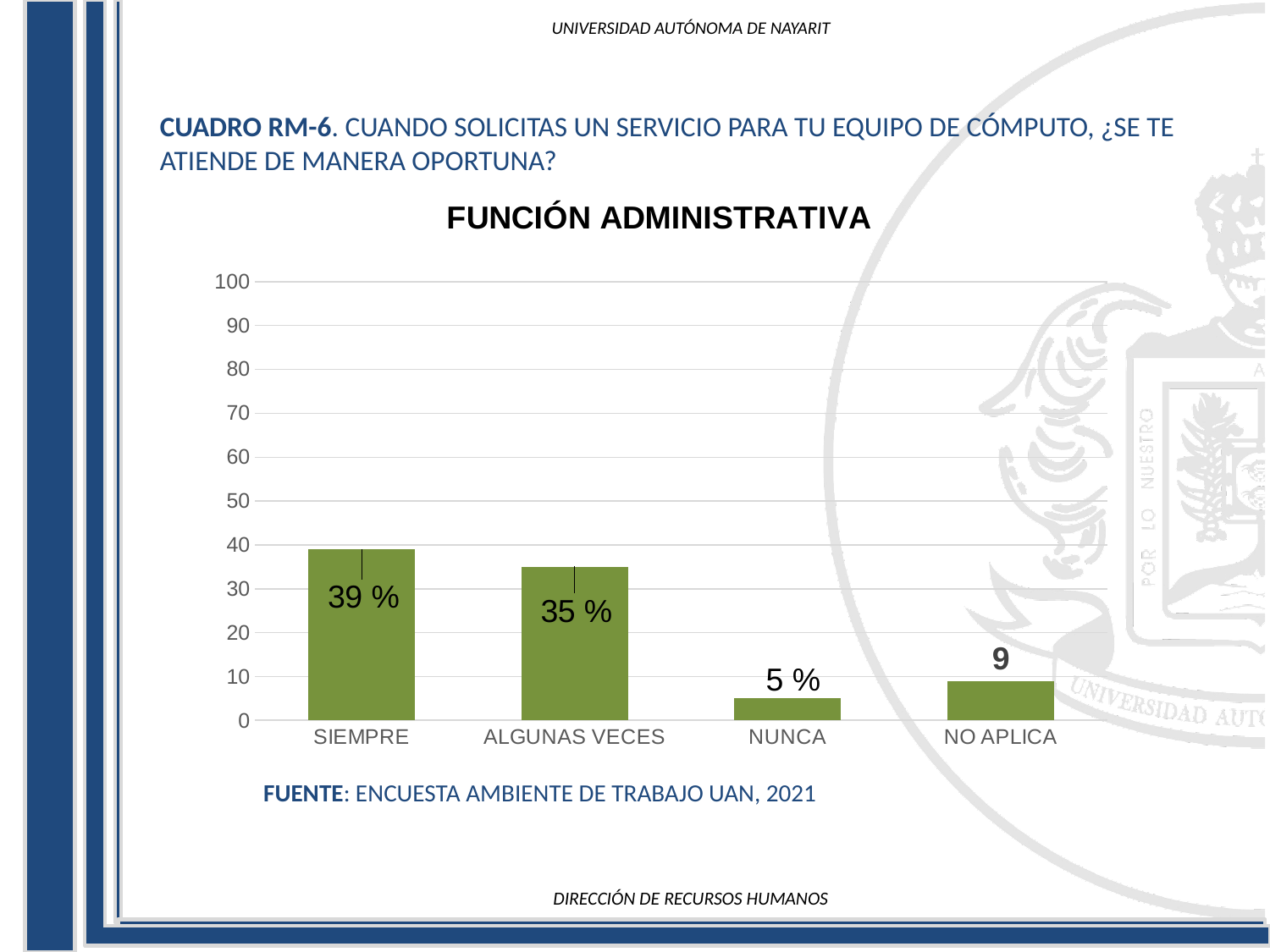
How many categories are shown on the x axis? 4 What is the data label shown for NO APLICA? 9 Is the value for SIEMPRE greater or less than 30? greater Which category has the lowest value? NUNCA Which category has the highest value? SIEMPRE Which is larger, the value for ALGUNAS VECES or the value for NUNCA? ALGUNAS VECES What is the value for NUNCA? 5 % What kind of chart is shown? bar chart What is the value for ALGUNAS VECES? 35 % What is the difference between the values for SIEMPRE and ALGUNAS VECES? 4 % What is the value for SIEMPRE? 39 % What is the title of the chart? FUNCIÓN ADMINISTRATIVA